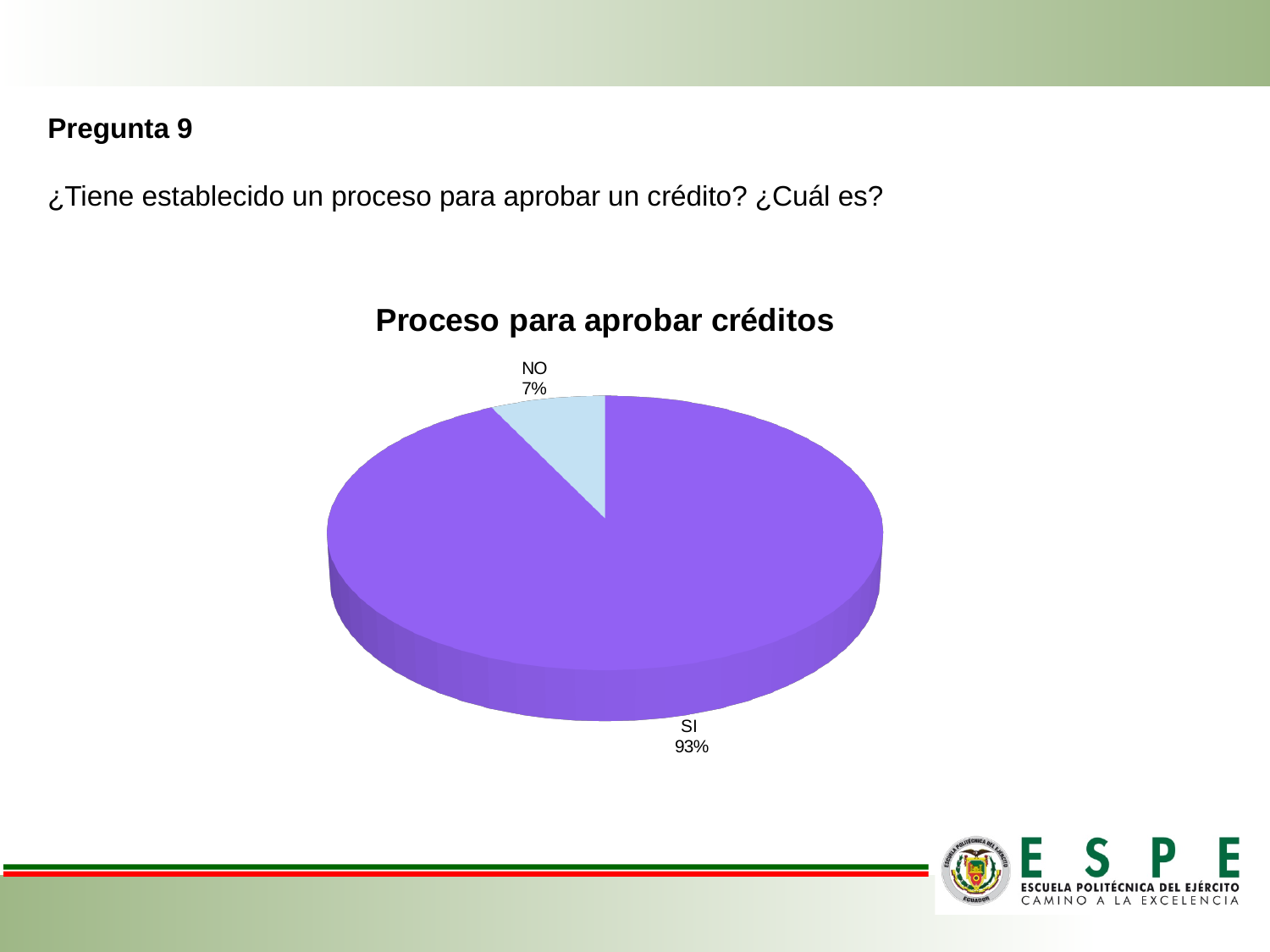
How many slices does the pie chart have? 2 Which slice of the pie is the smallest? NO What share of the pie does the SI slice represent? 93% What is the title of the chart? Proceso para aprobar créditos Which is larger, the SI slice or the NO slice? SI What percentage of the pie is labelled NO? 7% What colour is the SI slice of the pie? purple What percentage of the pie is labelled SI? 93% What kind of chart is shown on the slide? pie chart Which slice of the pie is the largest? SI What is the difference in percentage points between the SI and NO slices? 86